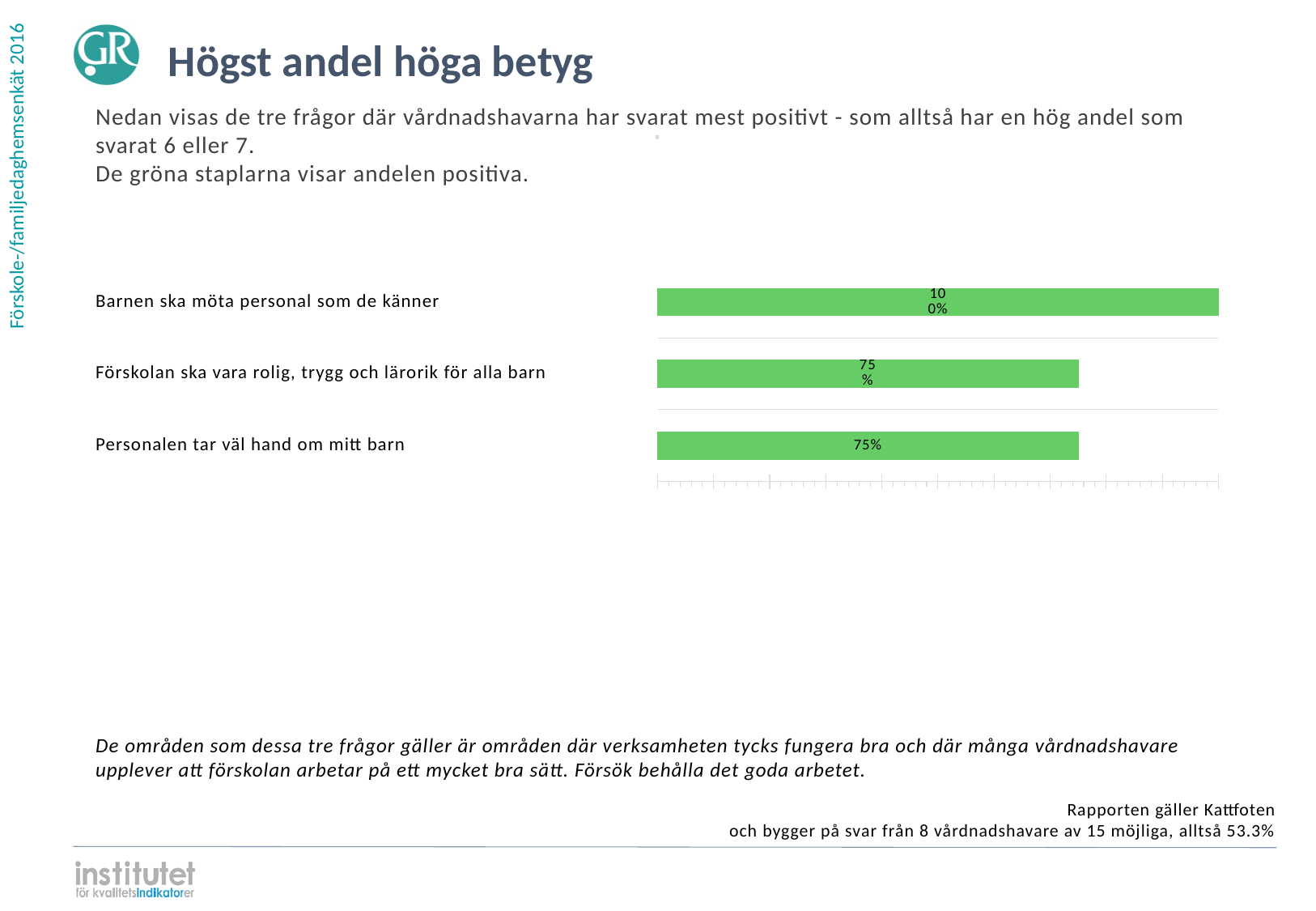
What colour are the bars in the chart? Green What is the value for "Förskolan ska vara rolig, trygg och lärorik för alla barn"? 75% What is the title of the slide containing the chart? Högst andel höga betyg What is the difference between the value for "Barnen ska möta personal som de känner" and the value for "Personalen tar väl hand om mitt barn"? 25% Which category has the highest value? Barnen ska möta personal som de känner What kind of chart is shown on the slide? Bar chart How many categories are shown in the chart? 3 What is the value for "Personalen tar väl hand om mitt barn"? 75% Do the values for "Förskolan ska vara rolig, trygg och lärorik för alla barn" and "Personalen tar väl hand om mitt barn" have the same value? Yes Which is larger: the value for "Barnen ska möta personal som de känner" or the value for "Förskolan ska vara rolig, trygg och lärorik för alla barn"? Barnen ska möta personal som de känner What is the value for "Barnen ska möta personal som de känner"? 100%